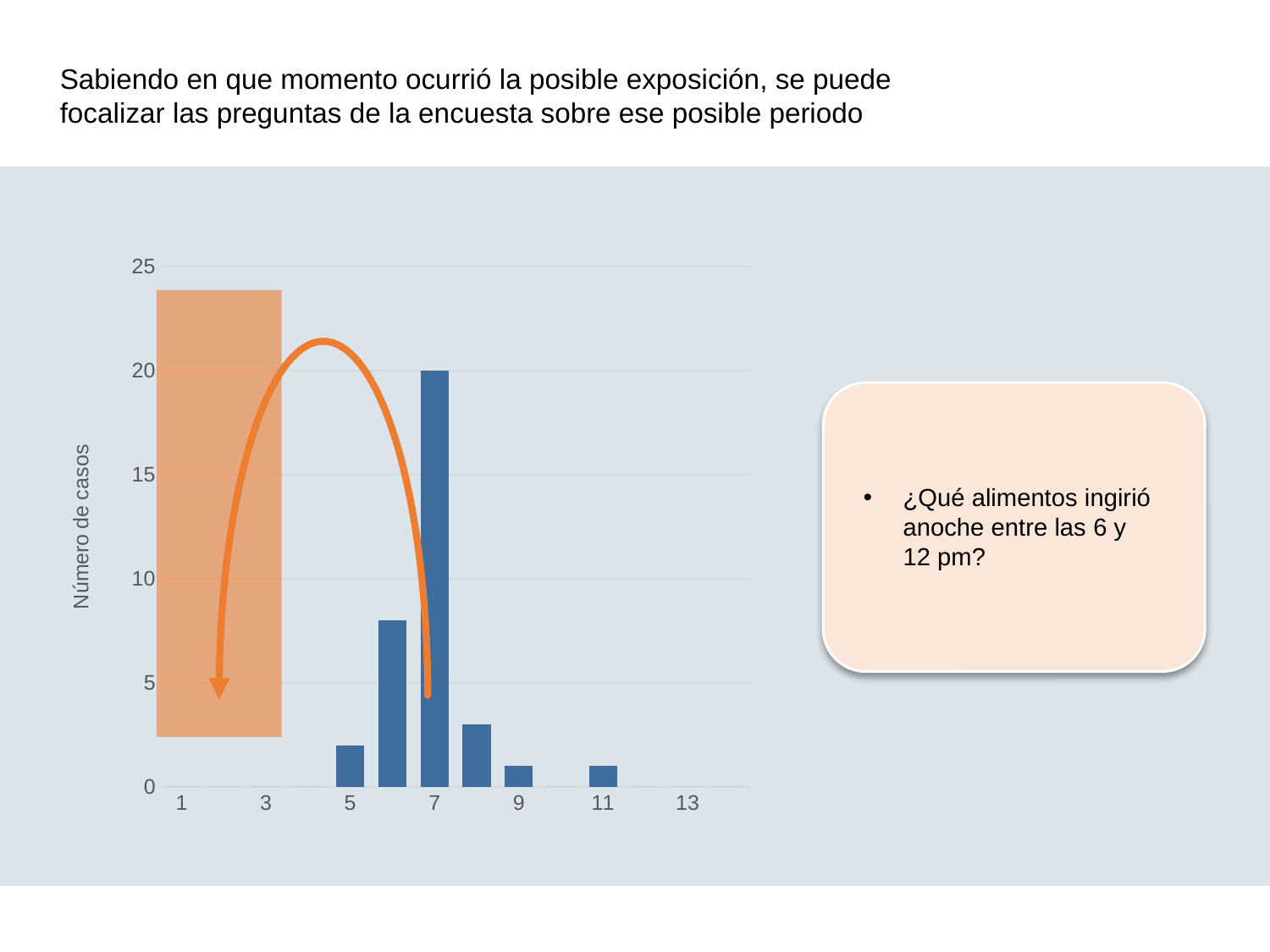
What is the highest value shown on the vertical axis? 25 Is the value for x = 8 greater or less than 5? less Do the values rise or fall from x = 7 to x = 9? fall Is the value for x = 6 greater or less than 10? less What is the value of the tallest bar, at x = 7? 20 Which is larger, the bar at x = 6 or the bar at x = 8? x = 6 How many bars are plotted in the chart? 6 Is the value for x = 5 greater or less than 5? less Which x-axis category has the highest number of cases? 7 What kind of chart is shown on the slide? bar chart What is the label of the vertical axis? Número de casos